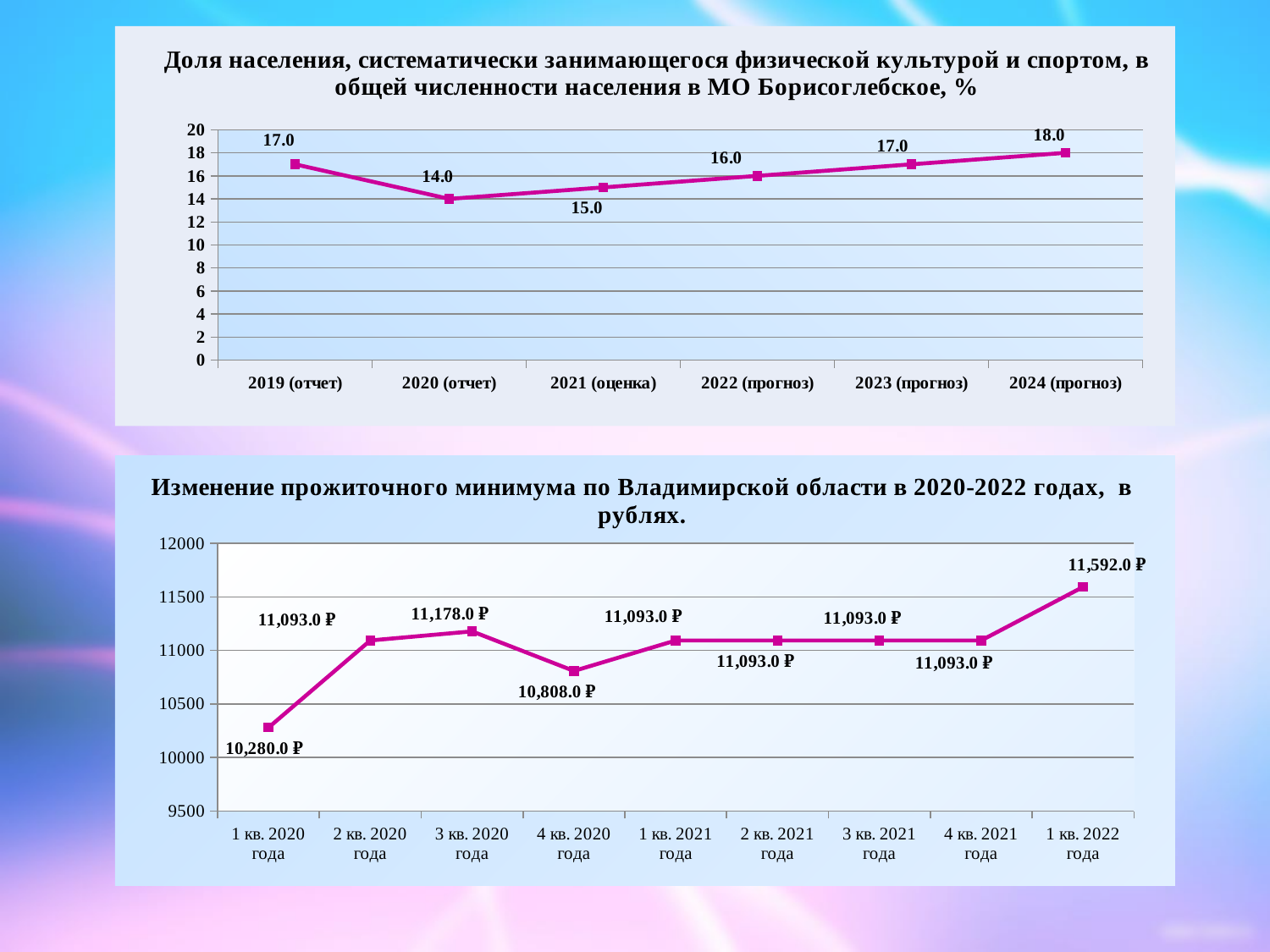
In the bottom chart (subsistence minimum in Vladimir region), what is the value for 1 кв. 2020 года? 10,280.0 ₽ In the top chart (share of population engaged in sport), what is the value for 2024 (прогноз)? 18.0 In the top chart (share of population engaged in sport), which year has the lowest value? 2020 (отчет) In the bottom chart (subsistence minimum in Vladimir region), what is the value for 4 кв. 2020 года? 10,808.0 ₽ In the bottom chart (subsistence minimum in Vladimir region), what is the difference between the value for 1 кв. 2022 года and the value for 4 кв. 2021 года? 499.0 ₽ In the top chart (share of population engaged in sport), what is the difference between the 2024 (прогноз) value and the 2020 (отчет) value? 4.0 What kind of chart is the bottom chart (subsistence minimum in Vladimir region)? line chart In the top chart (share of population engaged in sport), how many years are plotted on the x axis? 6 In the top chart (share of population engaged in sport), do the values rise or fall from 2020 (отчет) to 2024 (прогноз)? rise In the bottom chart (subsistence minimum in Vladimir region), which quarter has the highest value? 1 кв. 2022 года In the bottom chart (subsistence minimum in Vladimir region), how many quarters are plotted? 9 In the top chart (share of population systematically engaged in physical culture and sport), what is the value for 2020 (отчет)? 14.0